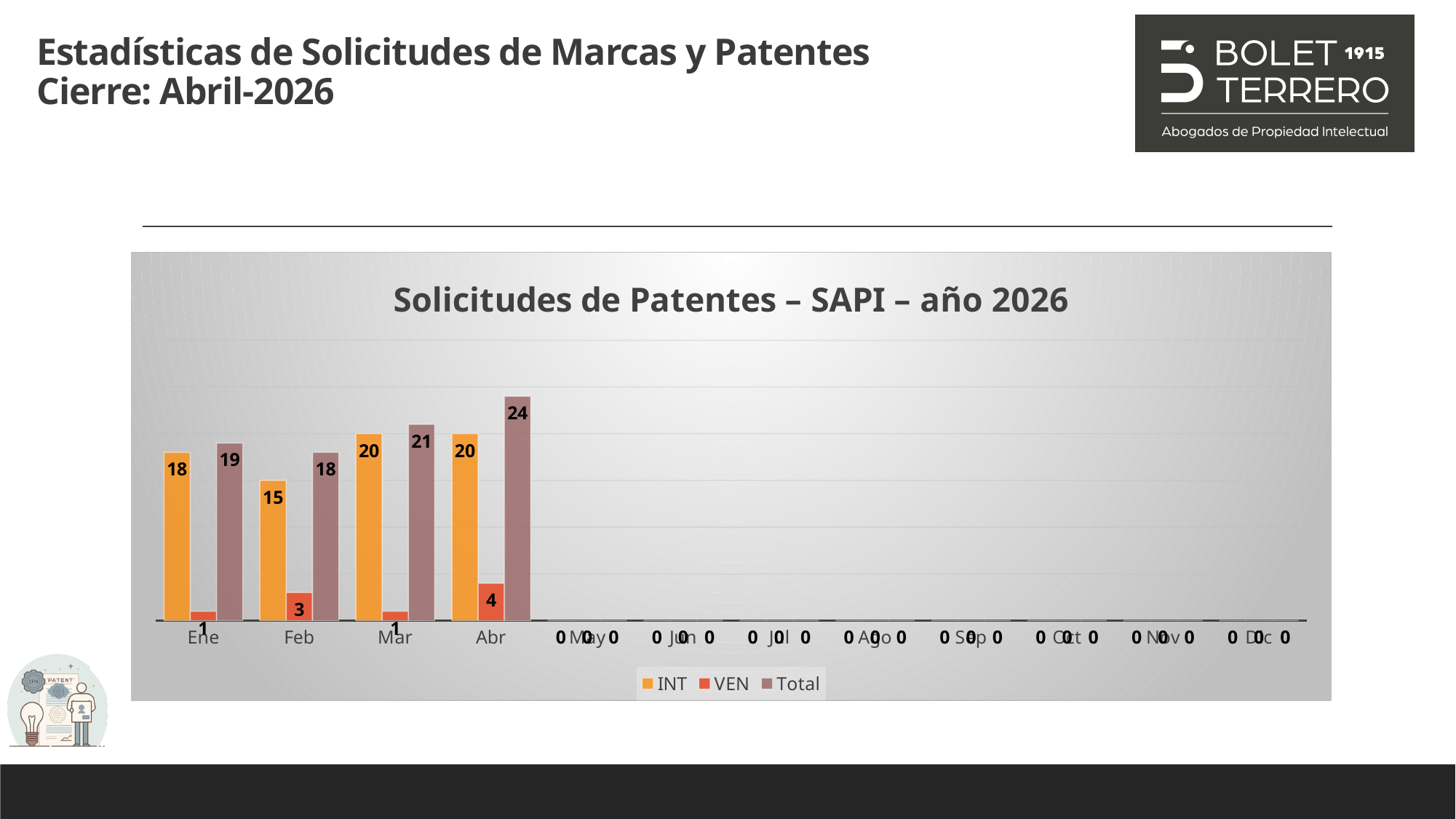
How many series does the legend list? 3 How many months are shown on the x axis? 12 What kind of chart is shown? Bar chart What is the INT value for Feb? 15 What is the difference between the Total values for Abr and Ene? 5 What is the Total value for Ene? 19 What is the VEN value for Abr? 4 Which month has the highest Total value? Abr Which month has the lowest INT value among Ene, Feb, Mar and Abr? Feb What is the Total value for Mar? 21 What is the title of the chart? Solicitudes de Patentes – SAPI – año 2026 Which is larger, the VEN value for Feb or the VEN value for Mar? Feb